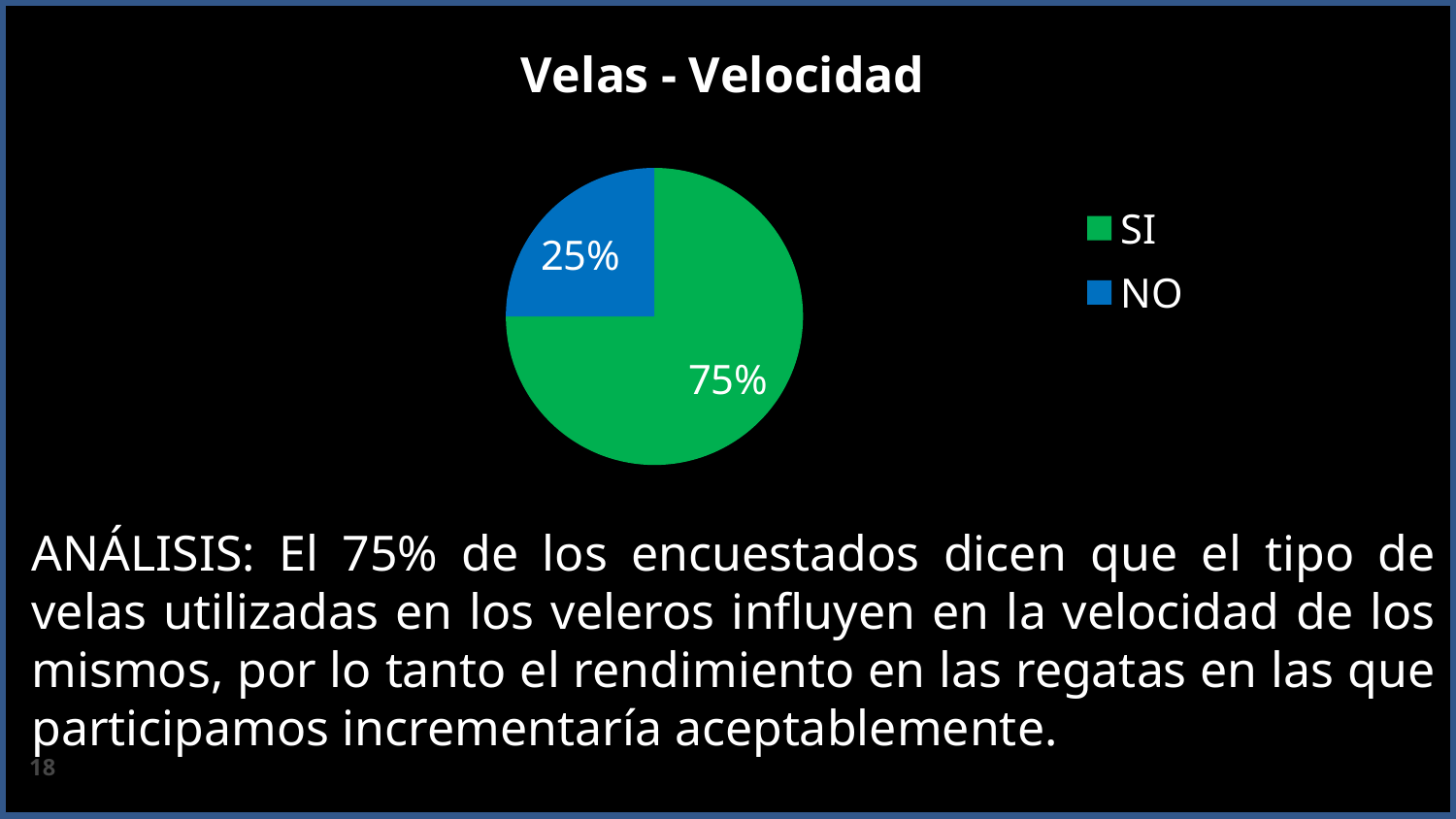
What colour is the SI slice? green What type of chart is shown on the slide? pie chart What is the title of the chart? Velas - Velocidad Which category has the smallest share of the pie? NO How many entries does the legend list? 2 How many categories does the pie chart show? 2 What percentage of the pie corresponds to NO? 25% What percentage of the pie corresponds to SI? 75% Which slice is larger, SI or NO? SI What share of the pie does the NO slice represent? 25% What is the difference in percentage points between the SI and NO slices? 50 Which category has the largest share of the pie? SI